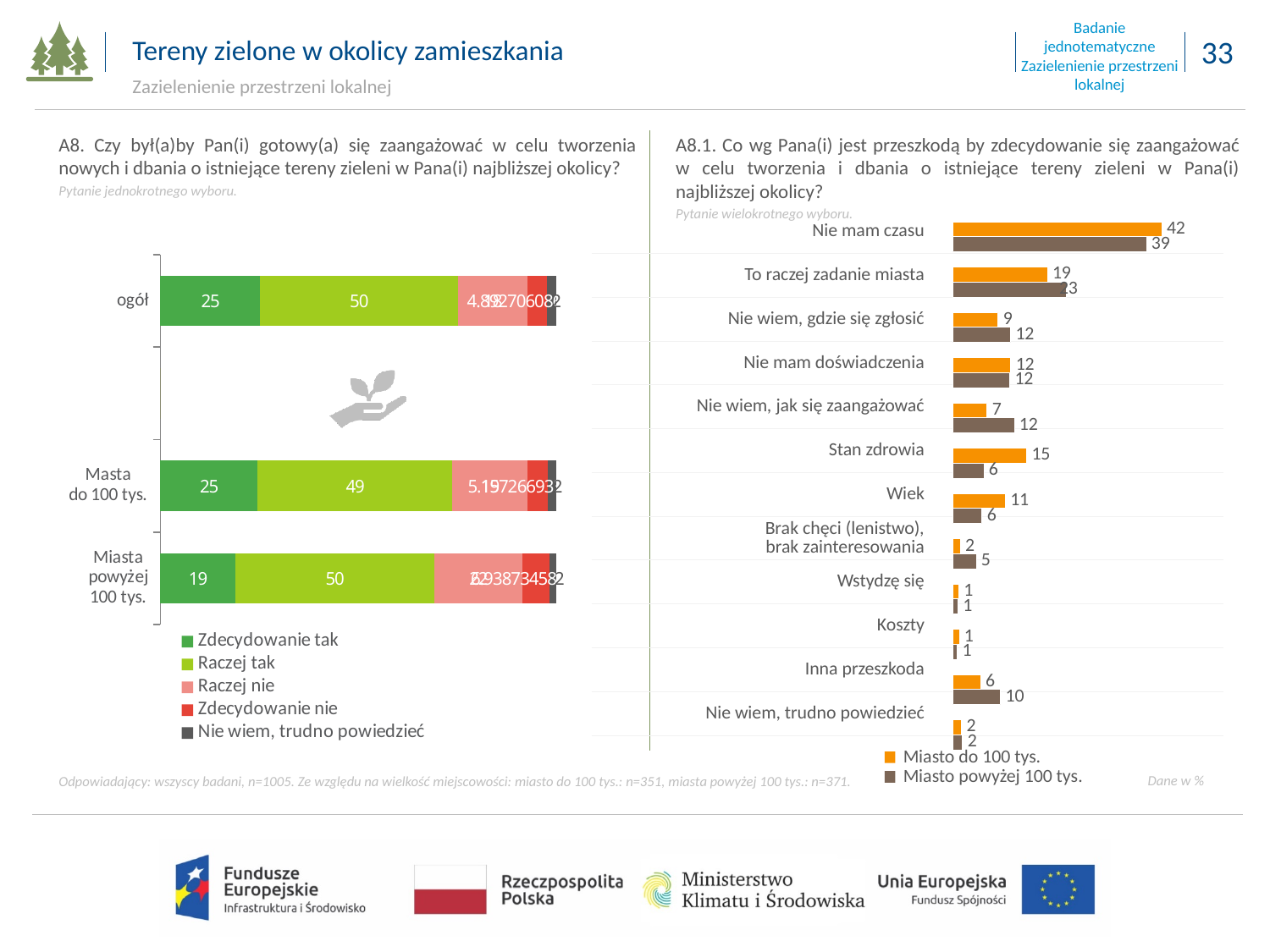
In the A8 chart on the left, what is the value of 'Zdecydowanie tak' for 'Miasta powyżej 100 tys.'? 19 In the A8 chart on the left, how many series does the legend list? 5 In the A8.1 chart on the right, what is the value for 'Stan zdrowia' for Miasto do 100 tys.? 15 In the A8.1 chart on the right, how many series does the legend list? 2 In the A8.1 chart on the right, how many categories are shown? 12 In the A8.1 chart on the right, what is the difference between Miasto do 100 tys. and Miasto powyżej 100 tys. for 'Stan zdrowia'? 9 In the A8.1 chart on the right, which category has the highest value for Miasto do 100 tys.? Nie mam czasu In the A8.1 chart on the right, what is the value for 'Nie mam czasu' for Miasto do 100 tys.? 42 What type of chart is the A8 chart on the left? Stacked bar chart In the A8 chart on the left, what is the value of 'Raczej tak' for 'ogół'? 50 In the A8.1 chart on the right, what is the value for 'Nie mam czasu' for Miasto powyżej 100 tys.? 39 In the A8.1 chart on the right, which is larger for 'Inna przeszkoda': Miasto do 100 tys. or Miasto powyżej 100 tys.? Miasto powyżej 100 tys.